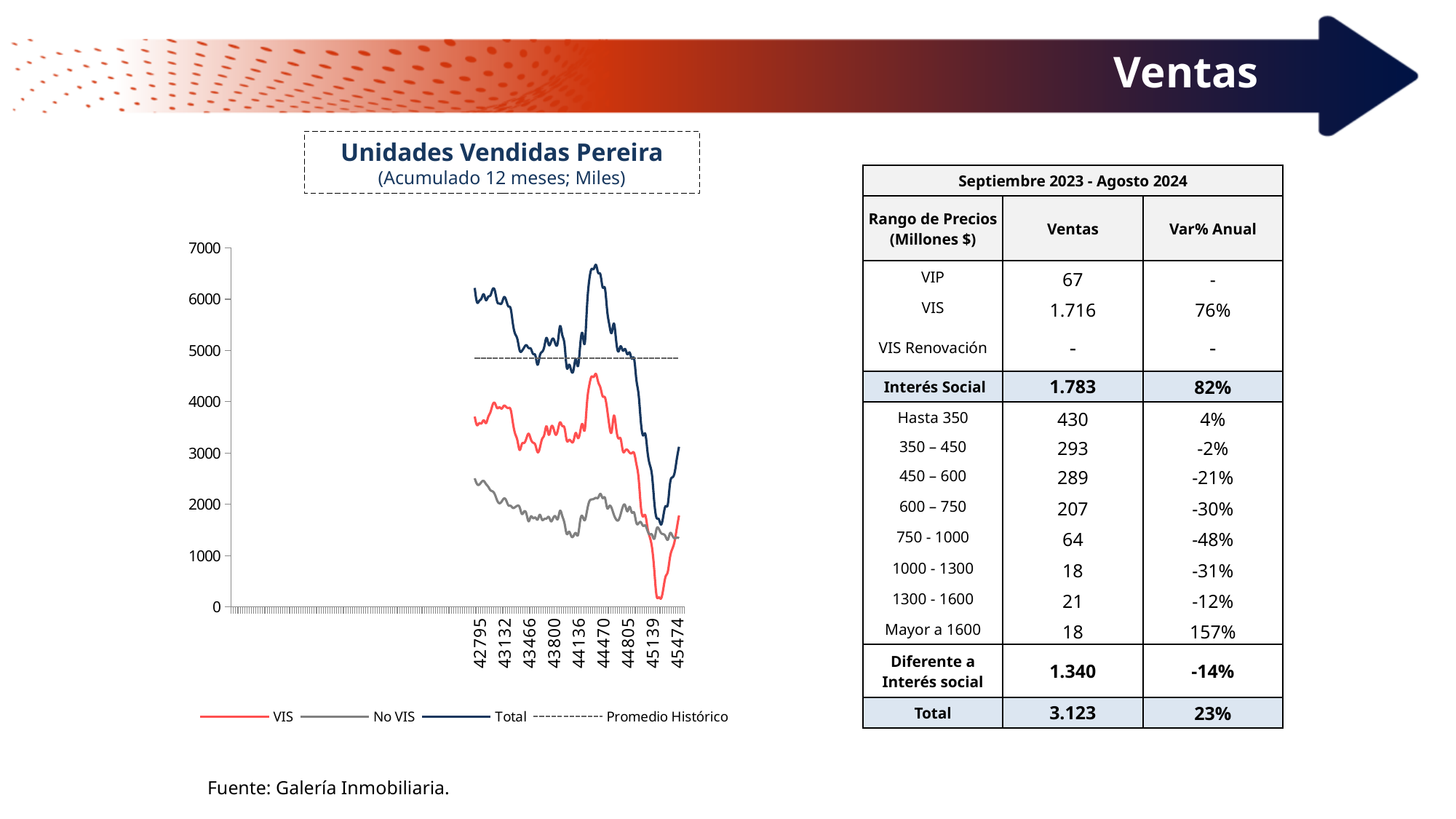
In the 'Unidades Vendidas Pereira' chart, is the peak value of the Total series around 44470 greater or less than 6000? greater In the 'Unidades Vendidas Pereira' chart, which series is lowest at 45139? VIS In the 'Unidades Vendidas Pereira' chart, is the No VIS value at 42795 greater or less than 2000? greater In the 'Unidades Vendidas Pereira' chart, which is larger at 45139: VIS or No VIS? No VIS In the 'Unidades Vendidas Pereira' chart, which series has the highest values across the whole period? Total What kind of chart is shown under the title 'Unidades Vendidas Pereira'? line chart How many series does the legend of the 'Unidades Vendidas Pereira' chart list? 4 What is the subtitle shown beneath the chart title 'Unidades Vendidas Pereira'? (Acumulado 12 meses; Miles) In the 'Unidades Vendidas Pereira' chart, is the Total value at 45139 greater or less than 3000? less Which series in the 'Unidades Vendidas Pereira' chart is drawn as a dashed line? Promedio Histórico In the 'Unidades Vendidas Pereira' chart, does the Total series rise or fall between 44470 and 45139? fall